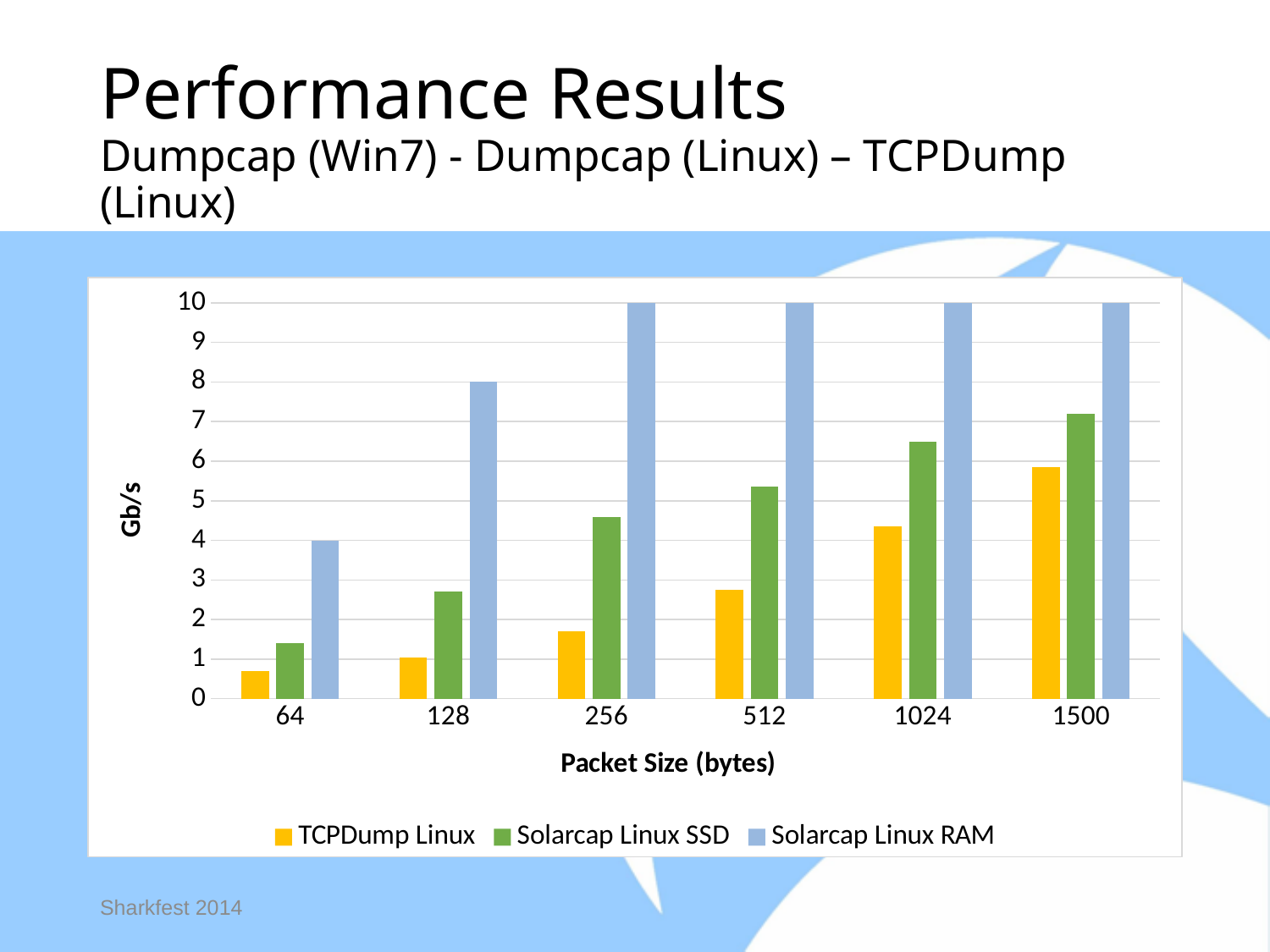
Do the TCPDump Linux values rise or fall as packet size increases? rise Is the value for TCPDump Linux at packet size 64 greater or less than 1? less Is the value for TCPDump Linux at packet size 1024 greater or less than 4? greater How many packet size categories are shown on the x axis? 6 Which series has the highest value at packet size 256? Solarcap Linux RAM What is the value for Solarcap Linux RAM at packet size 128? 8 How many series does the legend list? 3 Is the value for Solarcap Linux SSD at packet size 1500 greater or less than 7? greater What is the value for Solarcap Linux RAM at packet size 64? 4 What is the value for Solarcap Linux RAM at packet size 1500? 10 Which series has the lowest value at packet size 512? TCPDump Linux What type of chart is shown on the slide? bar chart